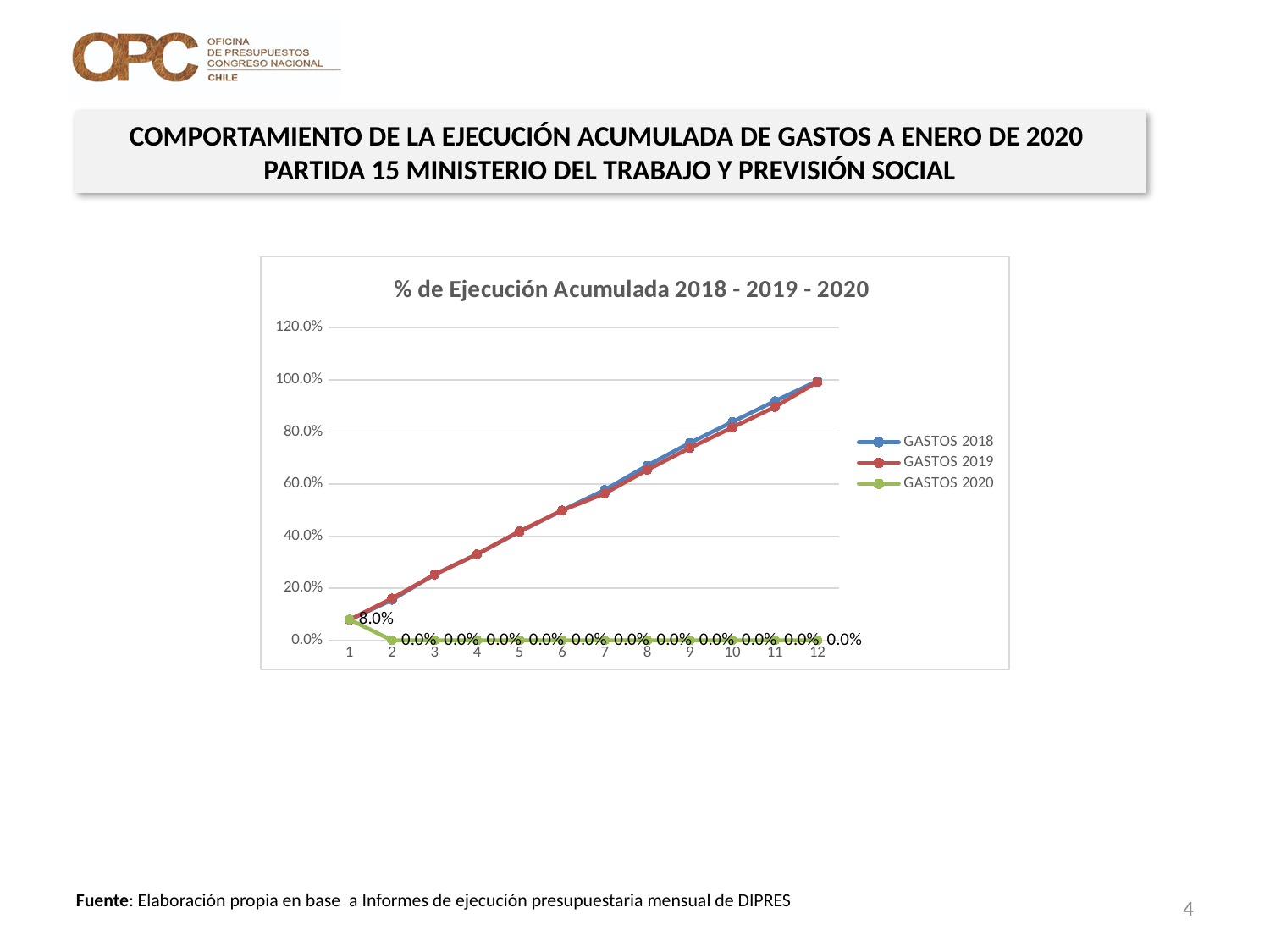
How many points are plotted along the x axis for each series? 12 Is the value for GASTOS 2019 at point 12 greater or less than 80.0%? greater What is the difference between GASTOS 2020 at point 1 and at point 2? 8.0% Which is larger at point 12: GASTOS 2019 or GASTOS 2020? GASTOS 2019 Is the value for GASTOS 2018 at point 3 greater or less than 40.0%? less What is the value of GASTOS 2020 at point 5? 0.0% At which x-axis point is GASTOS 2020 highest? 1 What is the value of GASTOS 2020 at point 1? 8.0% What kind of chart is shown on the slide? line chart How many series does the legend list? 3 What is the title of the chart? % de Ejecución Acumulada 2018 - 2019 - 2020 Do the values for GASTOS 2018 rise or fall from point 1 to point 12? rise